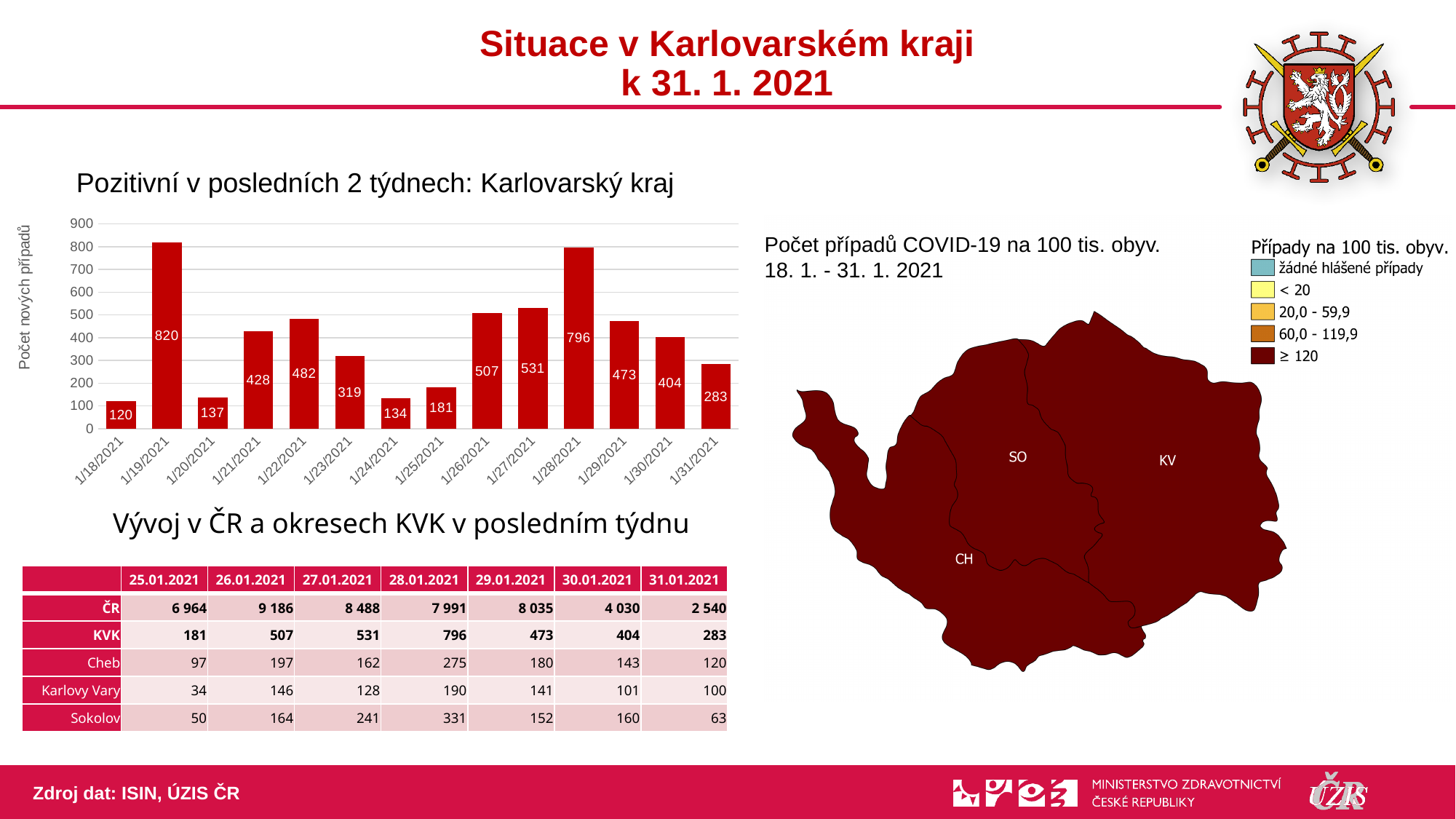
In the bar chart 'Pozitivní v posledních 2 týdnech: Karlovarský kraj', what is the value for 1/28/2021? 796 What type of chart is shown under the title 'Pozitivní v posledních 2 týdnech: Karlovarský kraj'? bar chart In the bar chart 'Pozitivní v posledních 2 týdnech: Karlovarský kraj', what is the value for 1/19/2021? 820 In the bar chart 'Pozitivní v posledních 2 týdnech: Karlovarský kraj', what is the difference between the values for 1/27/2021 and 1/26/2021? 24 What is the y-axis title of the bar chart 'Pozitivní v posledních 2 týdnech: Karlovarský kraj'? Počet nových případů In the bar chart 'Pozitivní v posledních 2 týdnech: Karlovarský kraj', do the values rise or fall from 1/25/2021 to 1/28/2021? rise In the bar chart 'Pozitivní v posledních 2 týdnech: Karlovarský kraj', which date has the highest value? 1/19/2021 In the bar chart 'Pozitivní v posledních 2 týdnech: Karlovarský kraj', which is larger, the value for 1/21/2021 or 1/22/2021? 1/22/2021 How many bars are in the bar chart 'Pozitivní v posledních 2 týdnech: Karlovarský kraj'? 14 In the bar chart 'Pozitivní v posledních 2 týdnech: Karlovarský kraj', what is the difference between the values for 1/19/2021 and 1/28/2021? 24 In the bar chart 'Pozitivní v posledních 2 týdnech: Karlovarský kraj', which date has the lowest value? 1/18/2021 In the bar chart 'Pozitivní v posledních 2 týdnech: Karlovarský kraj', what is the value for 1/23/2021? 319